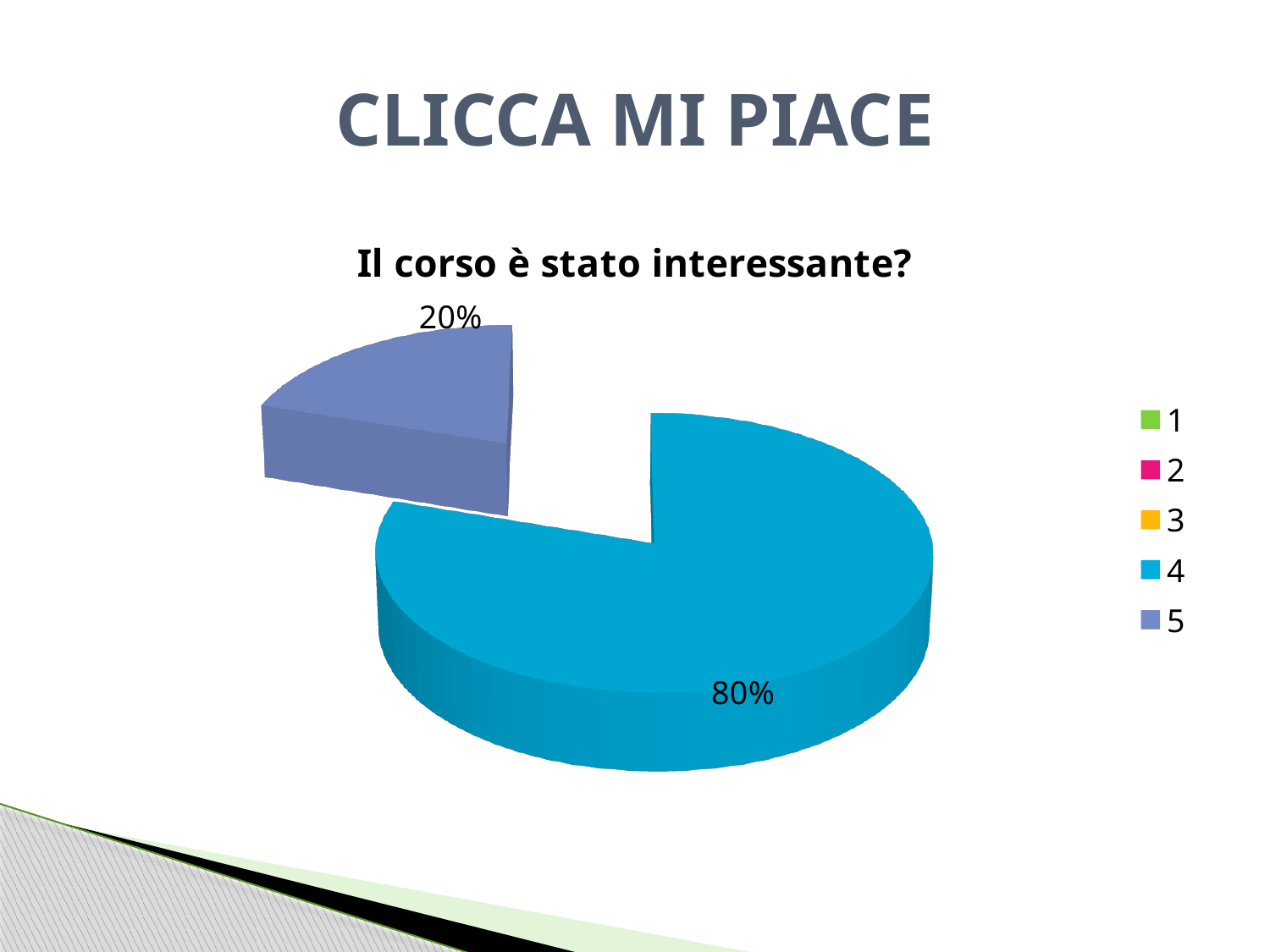
How many entries does the legend list? 5 Which of the two visible slices is larger, category 4 or category 5? 4 What is the total of the two labelled slices? 100% What kind of chart is shown on the slide? pie chart What share of the pie does category 5 have? 20% How many slices are visible in the pie? 2 What is the title of the chart? Il corso è stato interessante? What colour is the slice for category 4? blue What share of the pie does category 4 have? 80% Which category has the largest slice of the pie? 4 What is the difference in percentage points between the slice for category 4 and the slice for category 5? 60 percentage points